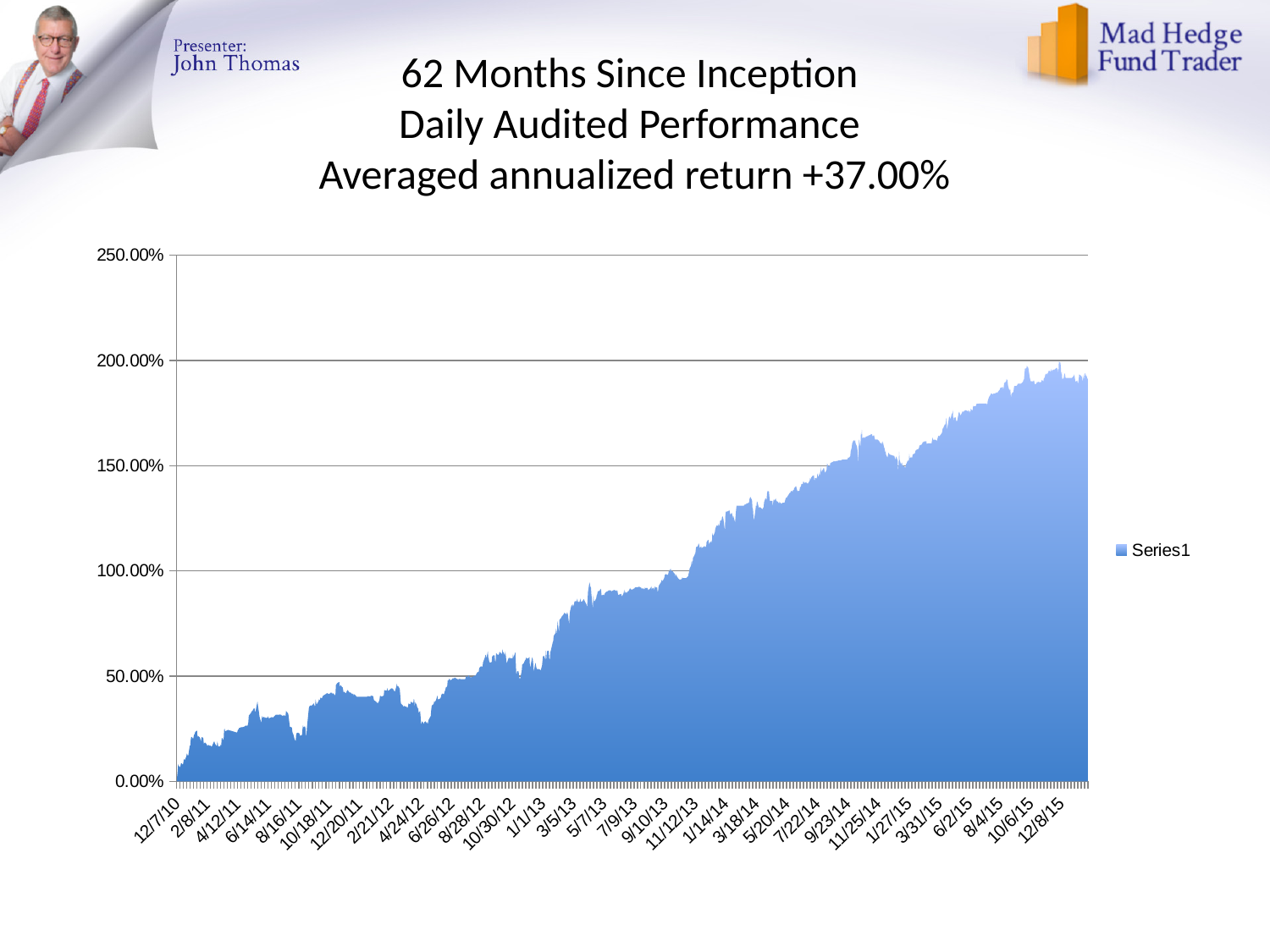
What is the highest tick value shown on the vertical axis? 250.00% Is the value at 8/28/12 greater or less than 100.00%? less Overall, do the values rise or fall from 12/7/10 to 12/8/15? Rise Is the value at 2/8/11 greater or less than 50.00%? less Is the value at 11/12/13 greater or less than 100.00%? greater What averaged annualized return does the chart title state? +37.00% What kind of chart is shown on the slide? Area chart How many series does the legend list? 1